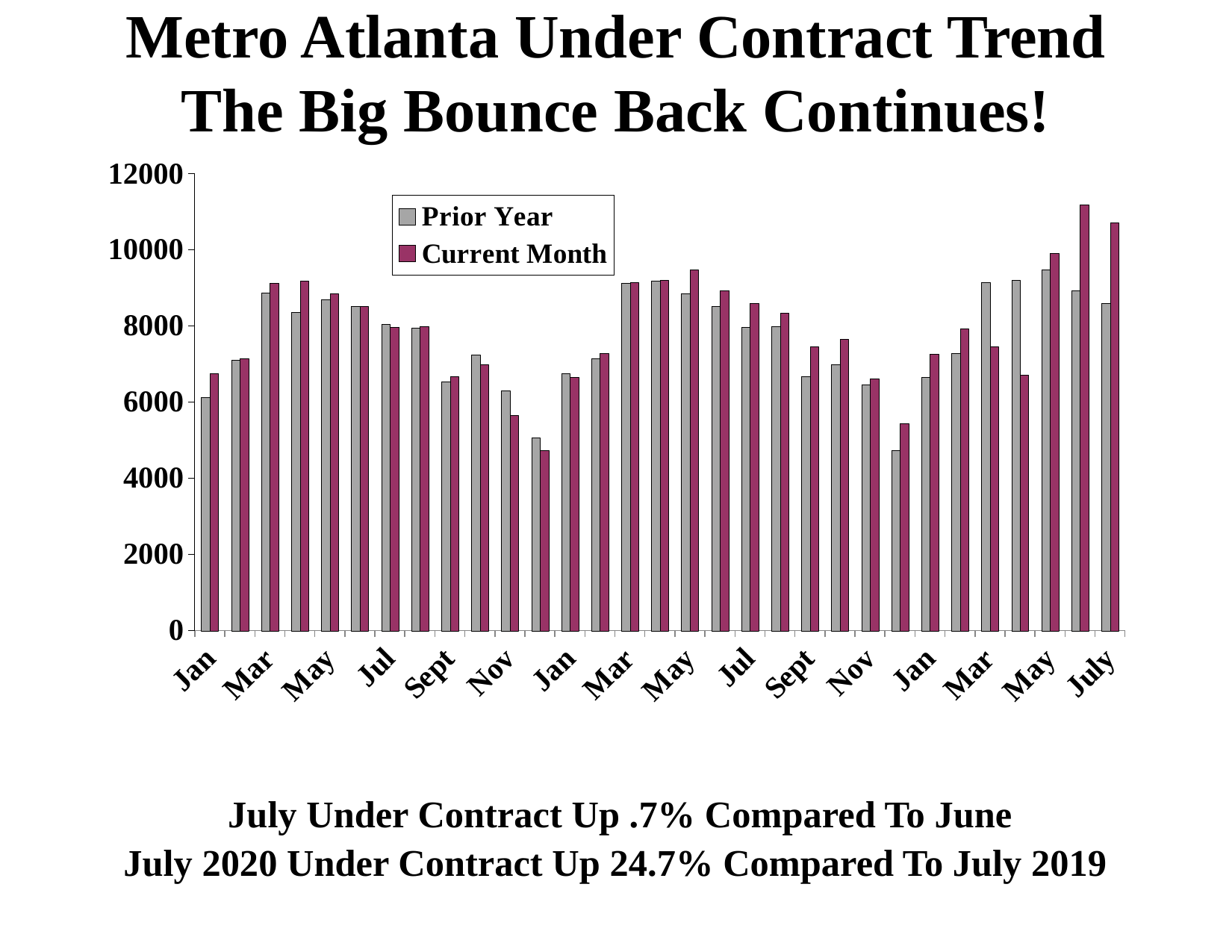
What kind of chart is shown on the slide? Bar chart Is the Current Month value for the final July greater or less than 10000? greater For the first Nov on the axis, which is larger: the Prior Year bar or the Current Month bar? Prior Year Is the Prior Year value for the last Jan on the axis greater or less than 4000? greater How many month labels are printed along the x axis? 16 Which series contains the tallest bar on the chart? Current Month What are the two series named in the legend? Prior Year and Current Month For the final July, which is larger: the Prior Year bar or the Current Month bar? Current Month Is the Current Month value for the last Jan on the axis greater or less than 6000? greater What colour are the Current Month bars? Maroon How many series does the legend list? 2